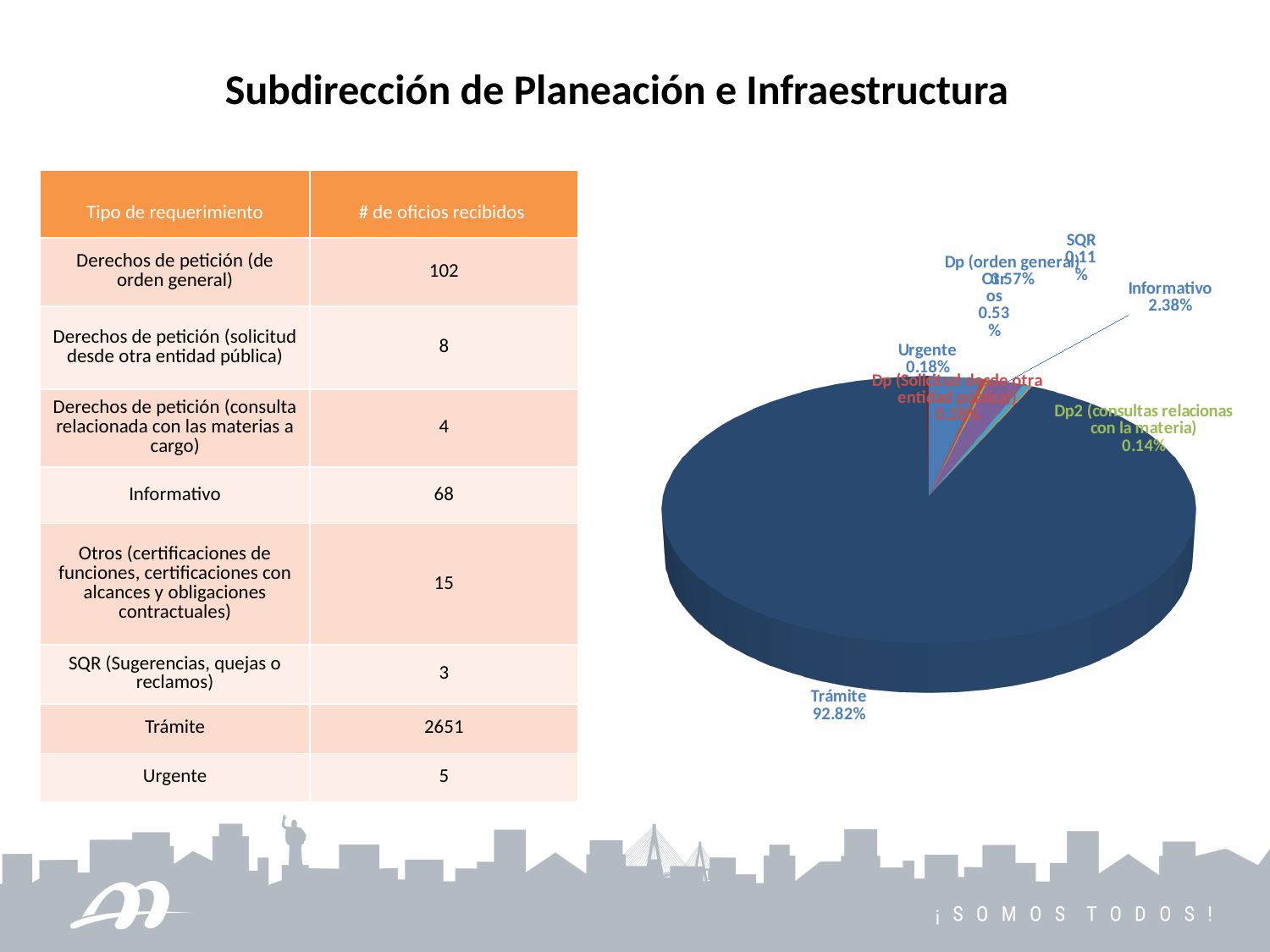
How many slices does the pie chart have? 8 What percentage is shown for Otros in the pie chart? 0.53% What percentage is shown for Urgente in the pie chart? 0.18% What kind of chart is shown on the slide? pie chart Which slice is larger in the pie chart, Informativo or Urgente? Informativo What colour is the Trámite slice in the pie chart? dark blue What percentage does the Trámite slice represent in the pie chart? 92.82% What is the difference in percentage points between the Trámite slice and the Informativo slice? 90.44% What percentage is shown for Dp2 (consultas relacionas con la materia) in the pie chart? 0.14% Which category has the smallest share in the pie chart? SQR Which category has the largest share of the pie chart? Trámite What percentage is shown for Informativo in the pie chart? 2.38%